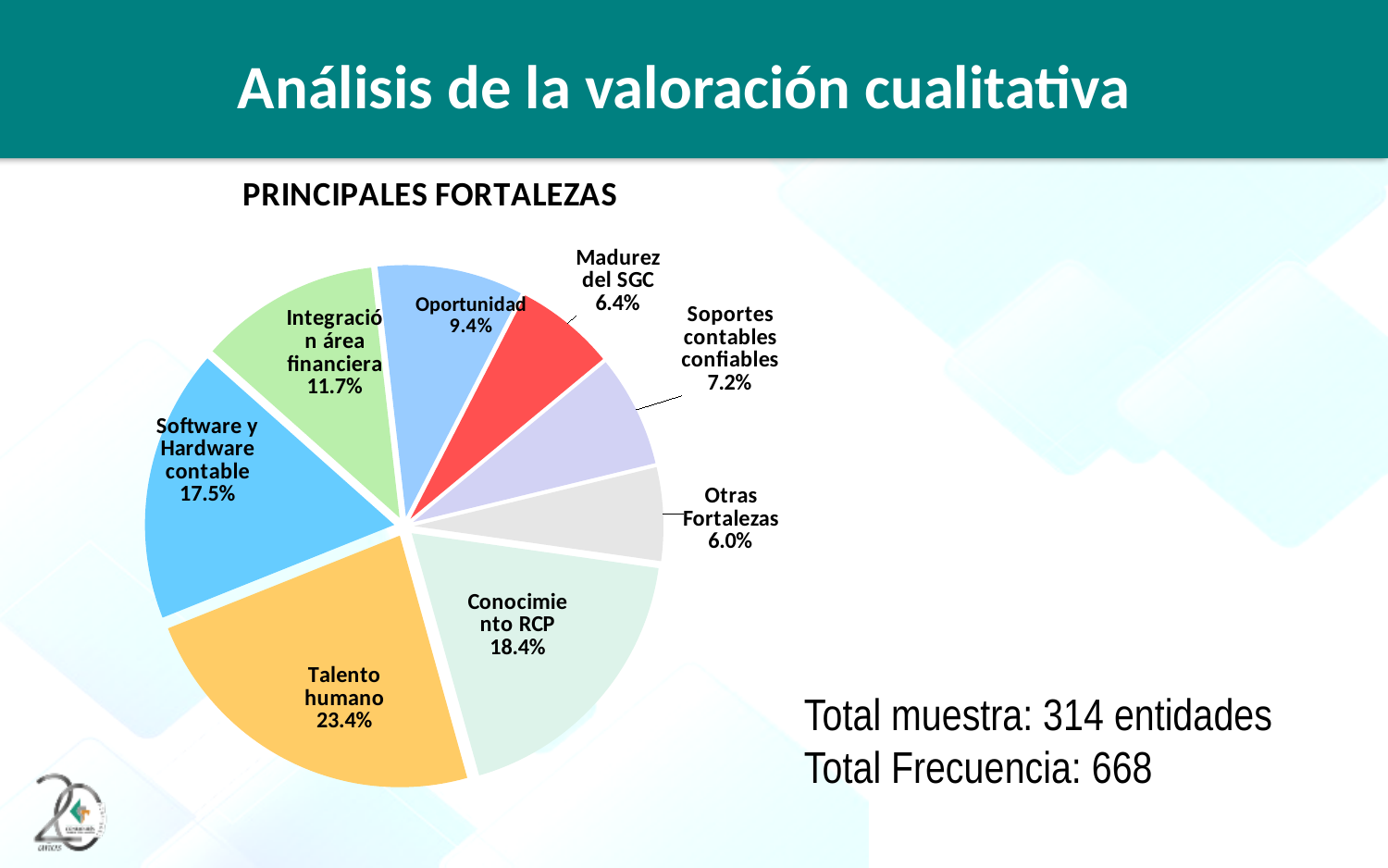
What kind of chart is shown on the slide? Pie chart What is the value shown for Madurez del SGC? 6.4% What is the difference between the values for Soportes contables confiables and Madurez del SGC? 0.8% What share of the pie does Talento humano represent? 23.4% Which category has the largest slice of the pie? Talento humano Which is larger, Integración área financiera or Oportunidad? Integración área financiera What is the title of the chart? PRINCIPALES FORTALEZAS How many slices does the pie chart have? 8 Which category has the smallest slice of the pie? Otras Fortalezas What is the value shown for Software y Hardware contable? 17.5% What is the value shown for Conocimiento RCP? 18.4% What is the difference between the values for Talento humano and Conocimiento RCP? 5.0%